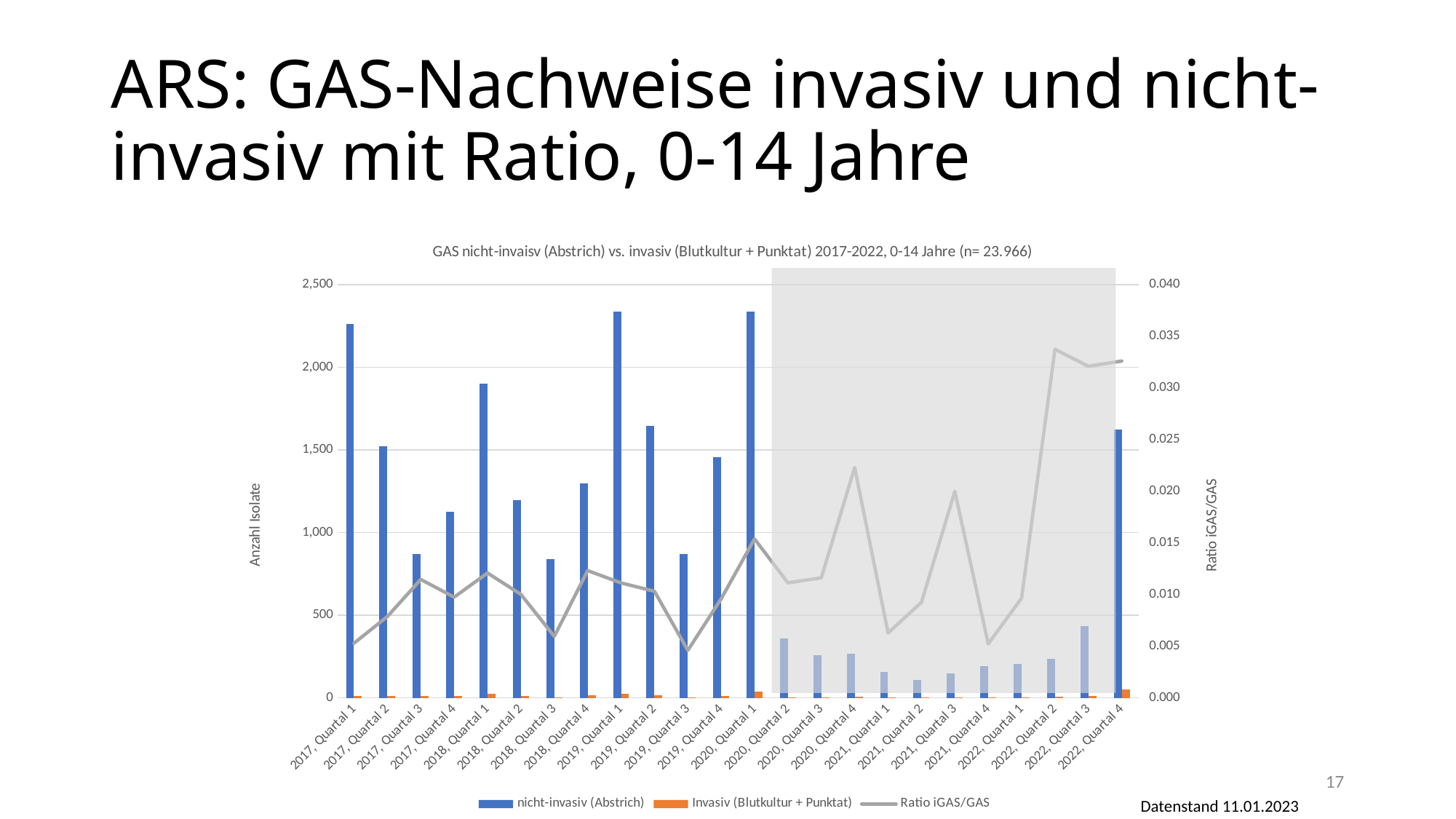
Is the Ratio iGAS/GAS value for 2019, Quartal 3 greater or less than 0.010? less How many series does the legend list? 3 Is the nicht-invasiv (Abstrich) value for 2021, Quartal 2 greater or less than 500? less Which is larger, the nicht-invasiv (Abstrich) value for 2018, Quartal 1 or for 2018, Quartal 2? 2018, Quartal 1 Is the nicht-invasiv (Abstrich) value for 2022, Quartal 4 greater or less than 1,500? greater What is the label of the right-hand vertical axis? Ratio iGAS/GAS Which quarter has the lowest nicht-invasiv (Abstrich) bar? 2021, Quartal 2 Does the Ratio iGAS/GAS line rise or fall from 2021, Quartal 4 to 2022, Quartal 2? rise How many quarters (categories) are shown on the x axis? 24 What kind of chart is shown on the slide? A combination bar and line chart